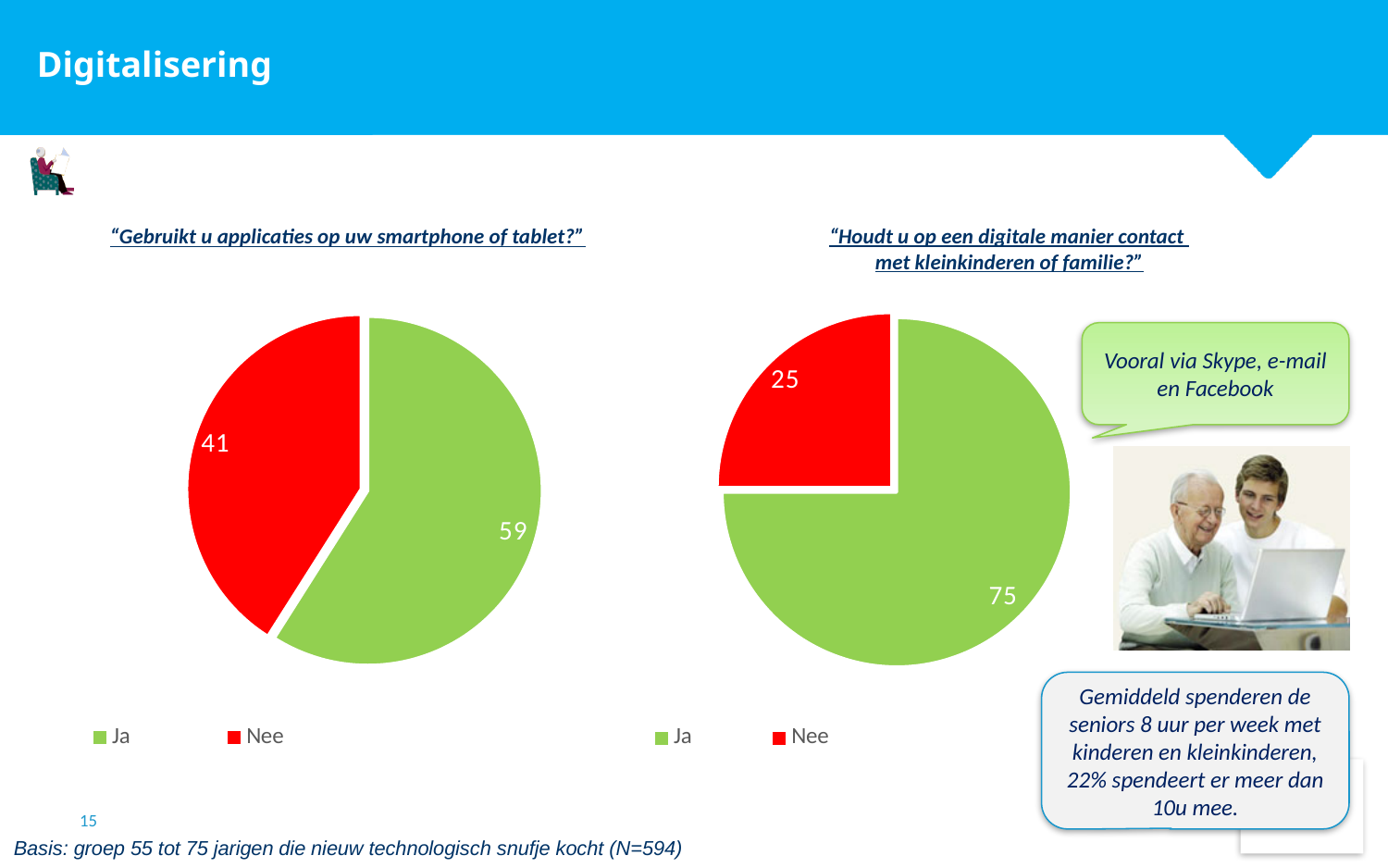
In the left chart ("Gebruikt u applicaties op uw smartphone of tablet?"), what is the value for Nee? 41 How many categories does the legend of the right chart list? 2 In the left chart, what is the difference between the Ja and Nee values? 18 In the left chart ("Gebruikt u applicaties op uw smartphone of tablet?"), what is the value for Ja? 59 In the right chart ("Houdt u op een digitale manier contact met kleinkinderen of familie?"), what is the value for Ja? 75 In the right chart, which category has the smallest slice? Nee In the right chart ("Houdt u op een digitale manier contact met kleinkinderen of familie?"), what is the value for Nee? 25 Is the Ja value larger in the left chart or in the right chart? Right chart In the right chart, what colour is the Nee slice? Red In the right chart, what is the difference between the Ja and Nee values? 50 What type of chart is used on the left side of the slide? Pie chart In the left chart, which category has the largest slice? Ja